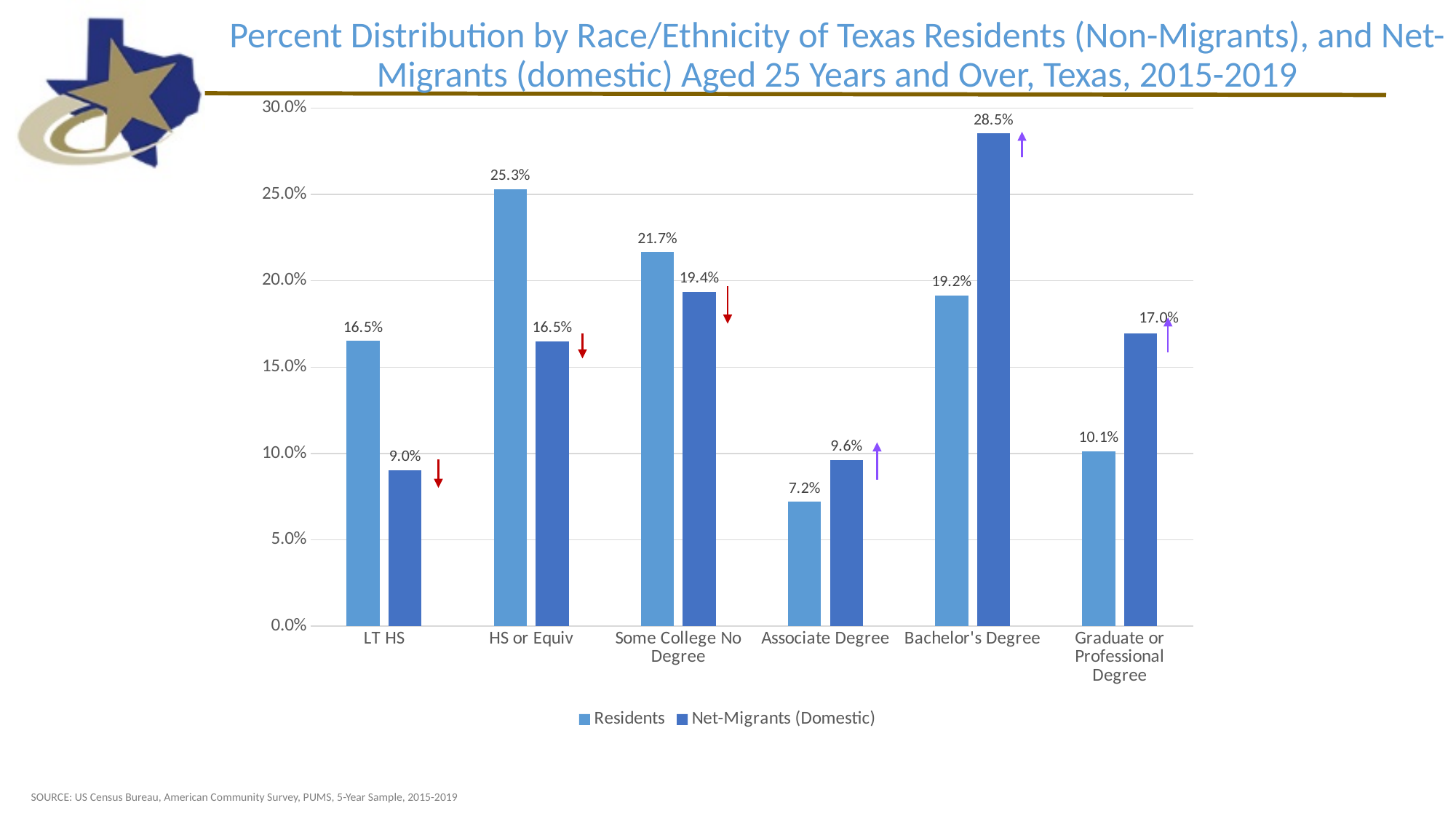
What is the Residents value for HS or Equiv? 25.3% Which category has the lowest Residents value? Associate Degree What is the difference between the Residents value for HS or Equiv and the Residents value for LT HS? 8.8% How many series does the legend list? 2 What kind of chart is shown on the slide? Bar chart How many education categories are shown on the x axis? 6 Which category has the highest Net-Migrants (Domestic) value? Bachelor's Degree What is the Net-Migrants (Domestic) value for LT HS? 9.0% What is the Net-Migrants (Domestic) value for Bachelor's Degree? 28.5% What is the Residents value for Graduate or Professional Degree? 10.1% What is the difference between the Residents and Net-Migrants (Domestic) values for Some College No Degree? 2.3% Which is larger for Graduate or Professional Degree: the Residents value or the Net-Migrants (Domestic) value? Net-Migrants (Domestic)